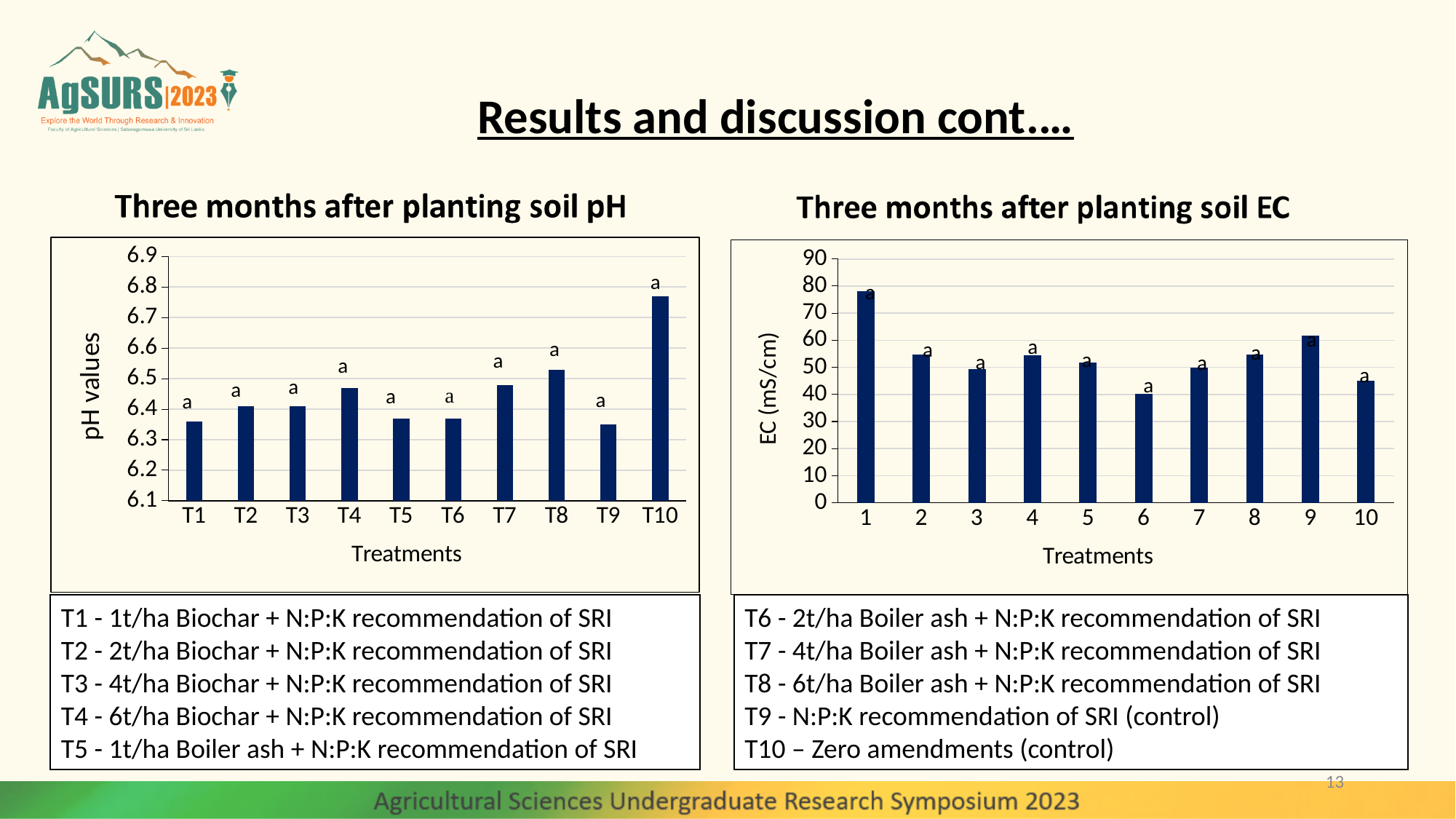
In the 'Three months after planting soil pH' chart, is the pH value for T10 greater or less than 6.7? greater In the 'Three months after planting soil EC' chart, which treatment has the highest EC? 1 In the 'Three months after planting soil EC' chart, which has the higher EC, treatment 1 or treatment 9? 1 In the 'Three months after planting soil EC' chart, is the EC for treatment 1 greater or less than 70? greater In the 'Three months after planting soil pH' chart, which treatment has the highest pH value? T10 In the 'Three months after planting soil EC' chart, which treatment has the lowest EC? 6 In the 'Three months after planting soil pH' chart, which has the higher pH value, T8 or T5? T8 What is the y-axis label of the 'Three months after planting soil EC' chart? EC (mS/cm) In the 'Three months after planting soil pH' chart, is the pH value for T9 greater or less than 6.4? less What kind of chart is the 'Three months after planting soil EC' chart? bar chart How many treatments are plotted in the 'Three months after planting soil pH' chart? 10